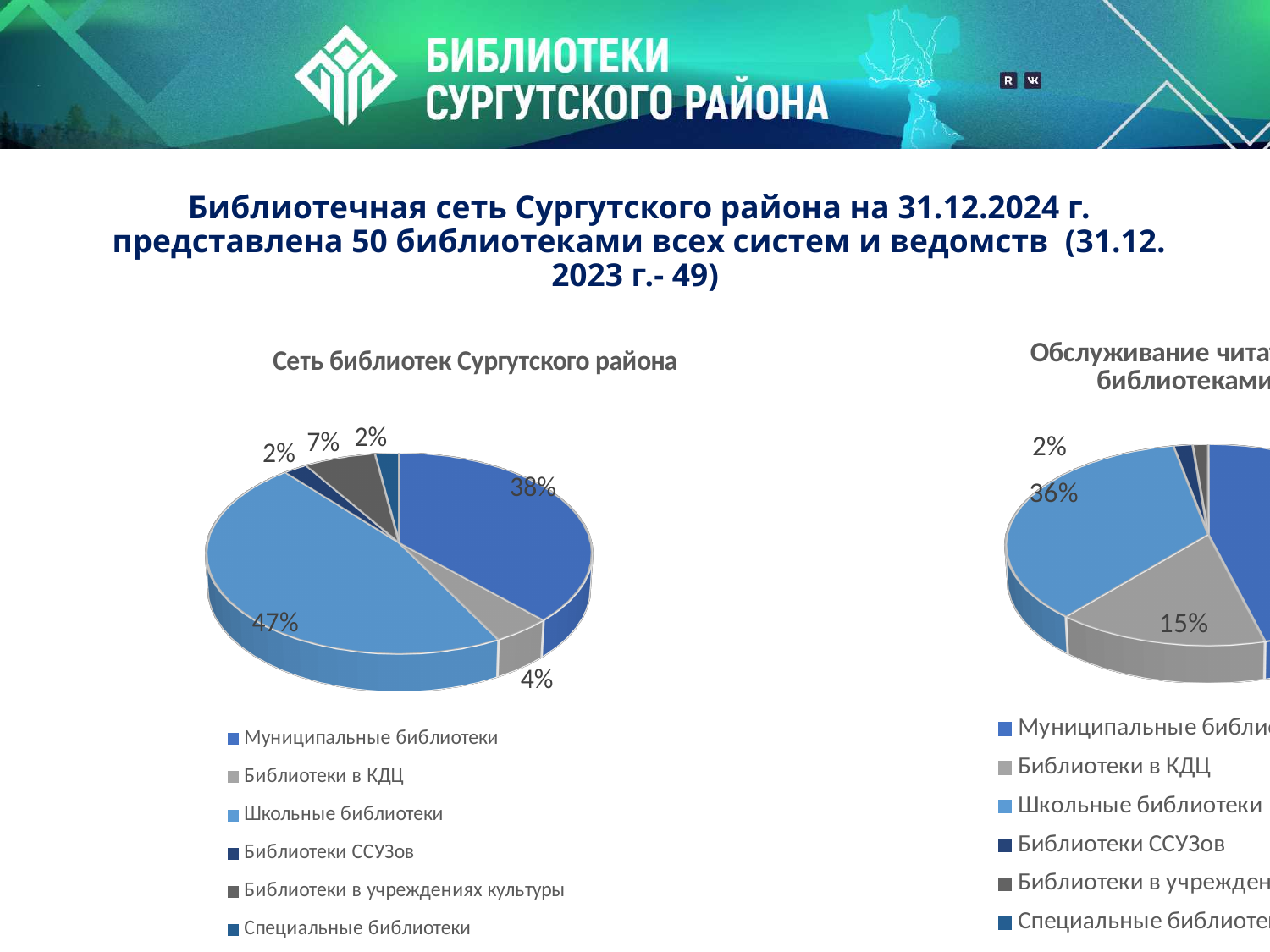
In the chart "Сеть библиотек Сургутского района", what share do Муниципальные библиотеки have? 38% In the chart "Сеть библиотек Сургутского района", what share do Библиотеки в КДЦ have? 4% In the chart "Сеть библиотек Сургутского района", how many percentage points larger is the share of Школьные библиотеки than that of Муниципальные библиотеки? 9 percentage points In the chart "Сеть библиотек Сургутского района", what share do Школьные библиотеки have? 47% What is the title of the pie chart on the left of the slide? Сеть библиотек Сургутского района In the chart "Сеть библиотек Сургутского района", which category has the largest share? Школьные библиотеки How many categories does the legend of the chart "Сеть библиотек Сургутского района" list? 6 What kind of chart is "Сеть библиотек Сургутского района"? Pie chart In the chart "Сеть библиотек Сургутского района", which is larger: Муниципальные библиотеки or Школьные библиотеки? Школьные библиотеки